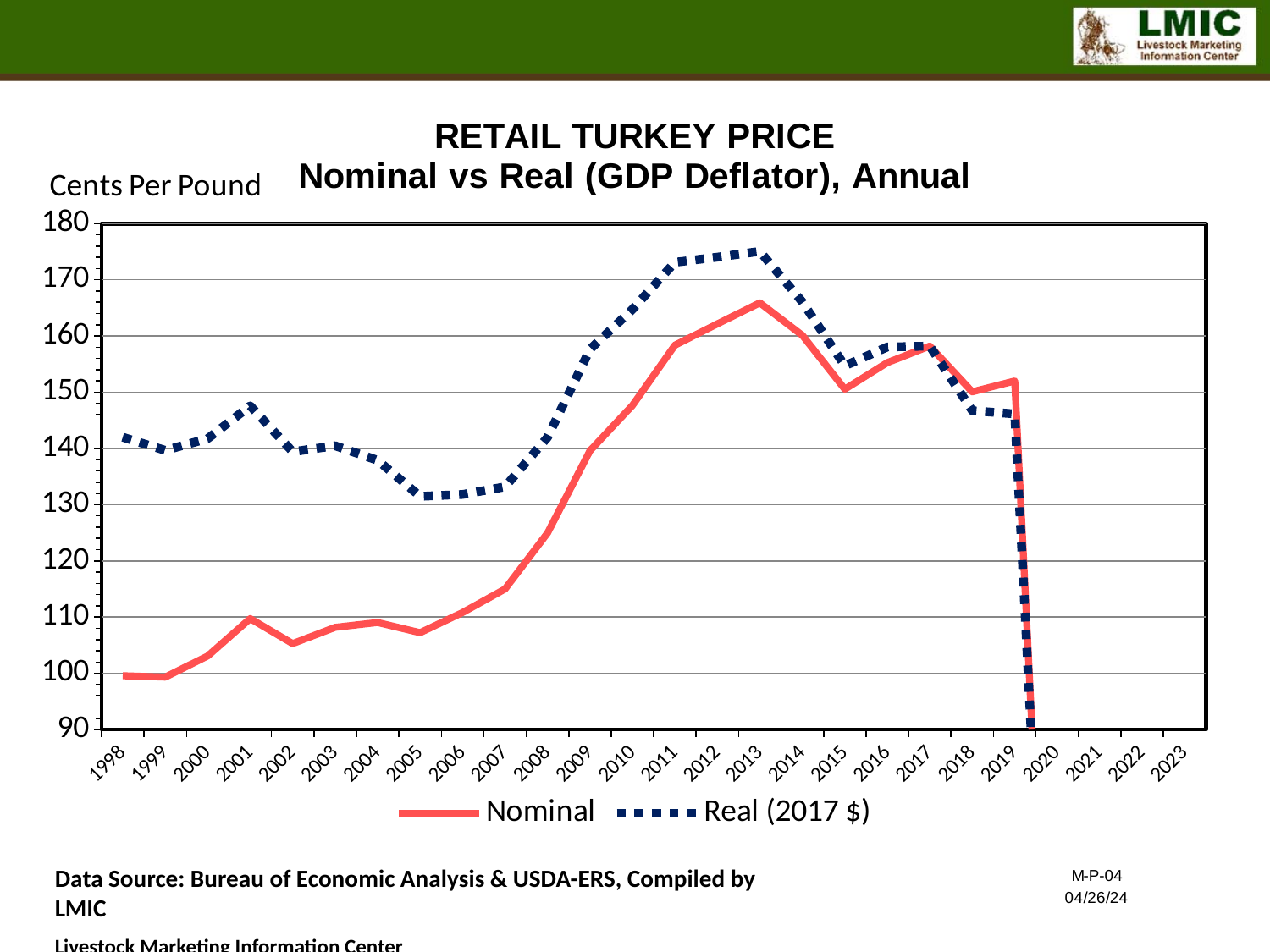
Is the Real (2017 $) value for 2013 greater or less than 170? greater How many series does the legend list? 2 Does the Nominal series rise or fall between 2005 and 2013? rise In which year does the Nominal series reach its highest value? 2013 Is the Nominal value for 2008 greater or less than 120? greater In which year does the Real (2017 $) series reach its highest value? 2013 What are the two series named in the legend? Nominal and Real (2017 $) What kind of chart is shown on the slide? line chart Is the Real (2017 $) value for 2001 greater or less than 150? less In 2010, which series has the larger value, Nominal or Real (2017 $)? Real (2017 $) What unit is shown on the y axis label? Cents Per Pound